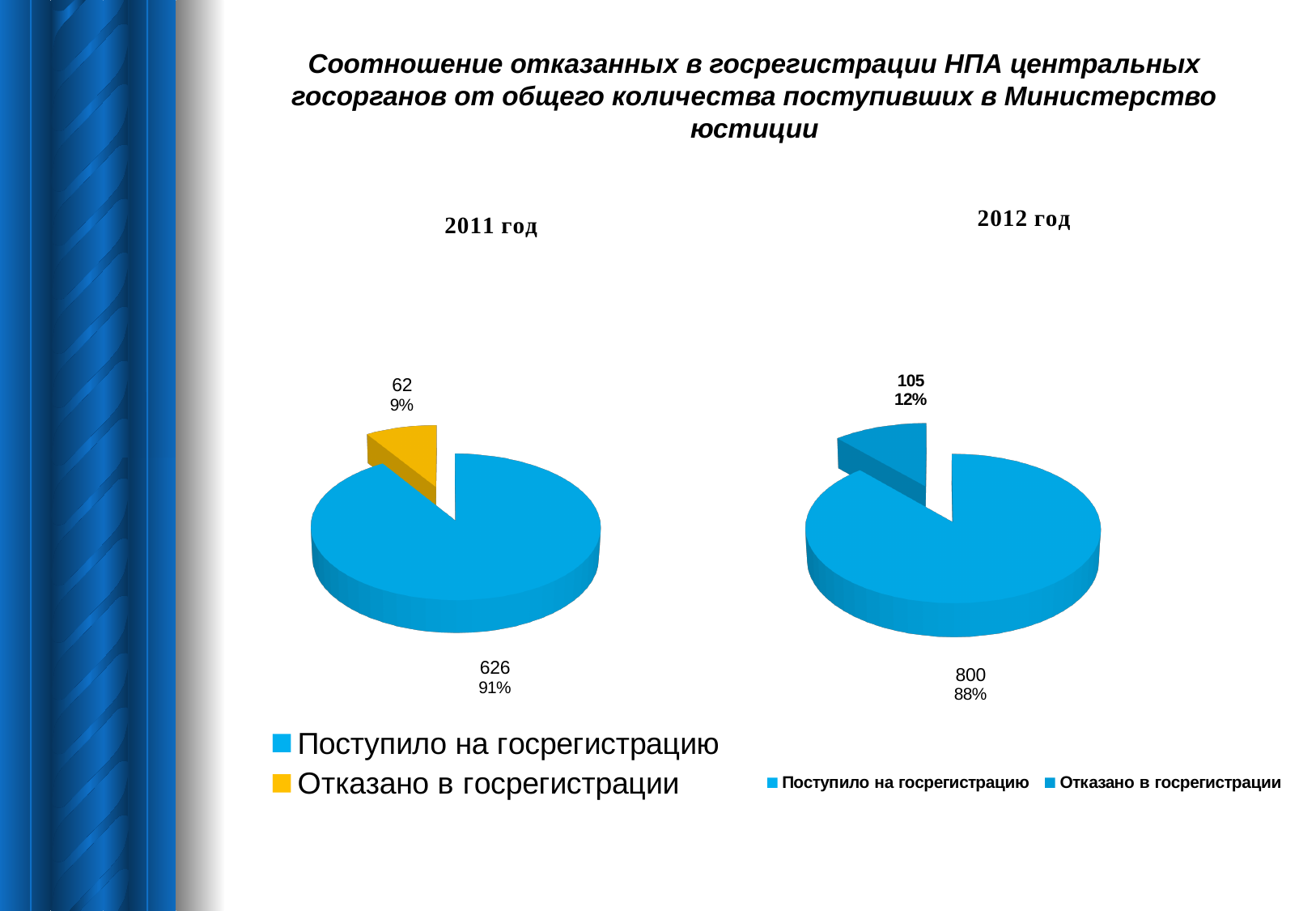
In the 2011 год chart, what value is shown for Отказано в госрегистрации? 62 In the 2012 год chart, what value is shown for Поступило на госрегистрацию? 800 In the 2012 год chart, what value is shown for Отказано в госрегистрации? 105 In the 2011 год chart, what value is shown for Поступило на госрегистрацию? 626 How many entries does the legend of the 2012 год chart list? 2 In the 2012 год chart, which slice is the largest? Поступило на госрегистрацию Which is larger: the Отказано в госрегистрации value in the 2011 год chart or in the 2012 год chart? 2012 год In the 2011 год chart, what share of the pie does Отказано в госрегистрации take? 9% What type of chart is the 2011 год chart? Pie chart In the 2012 год chart, what share of the pie does Поступило на госрегистрацию take? 88% In the 2011 год chart, which slice is the smallest? Отказано в госрегистрации What is the difference between the Поступило на госрегистрацию value in the 2012 год chart and in the 2011 год chart? 174